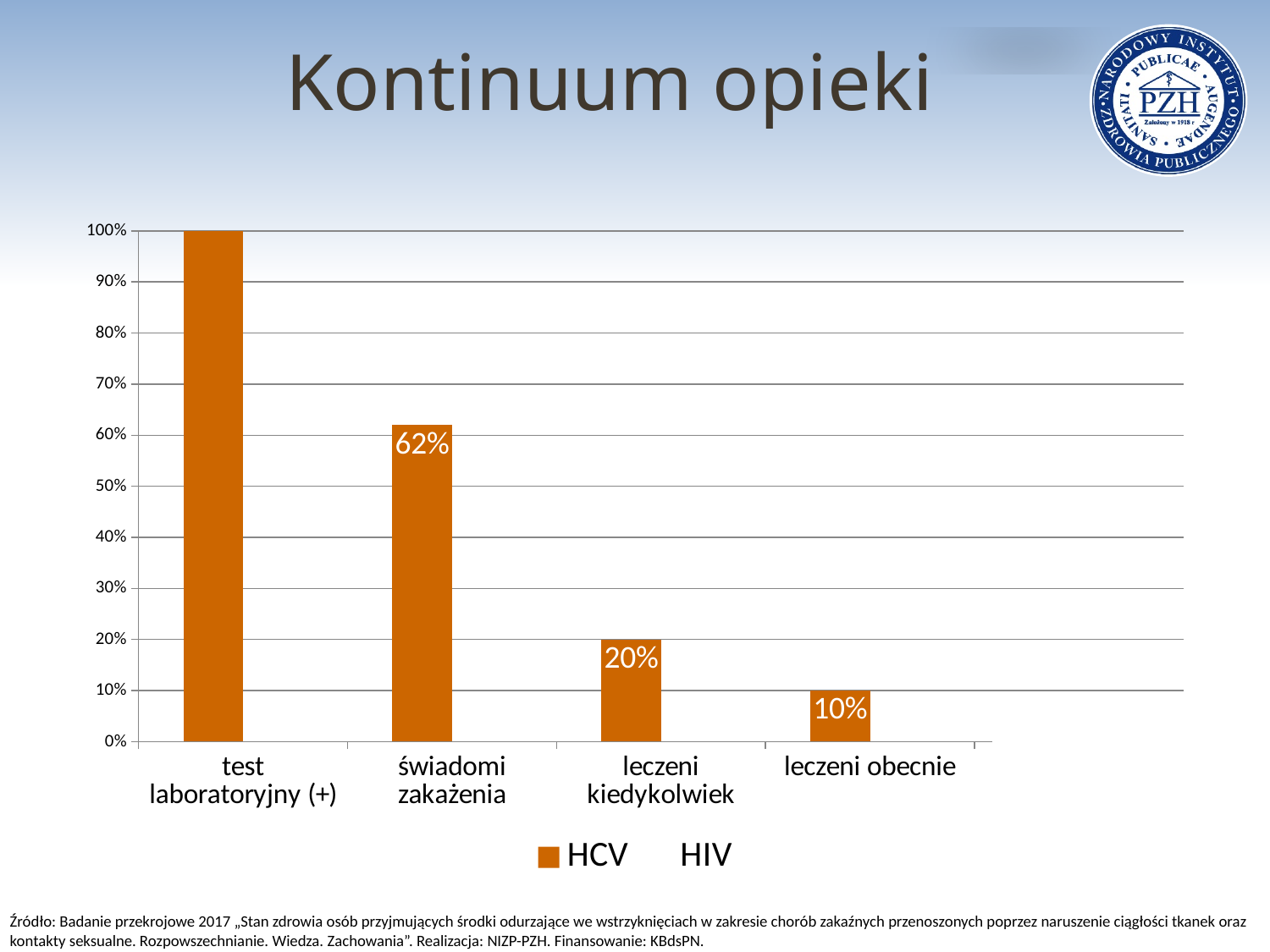
What is the difference between the HCV values for świadomi zakażenia and leczeni kiedykolwiek? 42% Is the HCV value for test laboratoryjny (+) greater or less than 90%? greater Which category has the highest HCV value? test laboratoryjny (+) How many categories are shown on the x axis? 4 What is the HCV value for leczeni kiedykolwiek? 20% How many series does the legend list? 2 What is the HCV value for świadomi zakażenia? 62% Which category has the lowest HCV value? leczeni obecnie Which is larger, the HCV value for świadomi zakażenia or for leczeni obecnie? świadomi zakażenia What kind of chart is shown on the slide? bar chart What is the HCV value for leczeni obecnie? 10% What is the difference between the HCV values for leczeni kiedykolwiek and leczeni obecnie? 10%